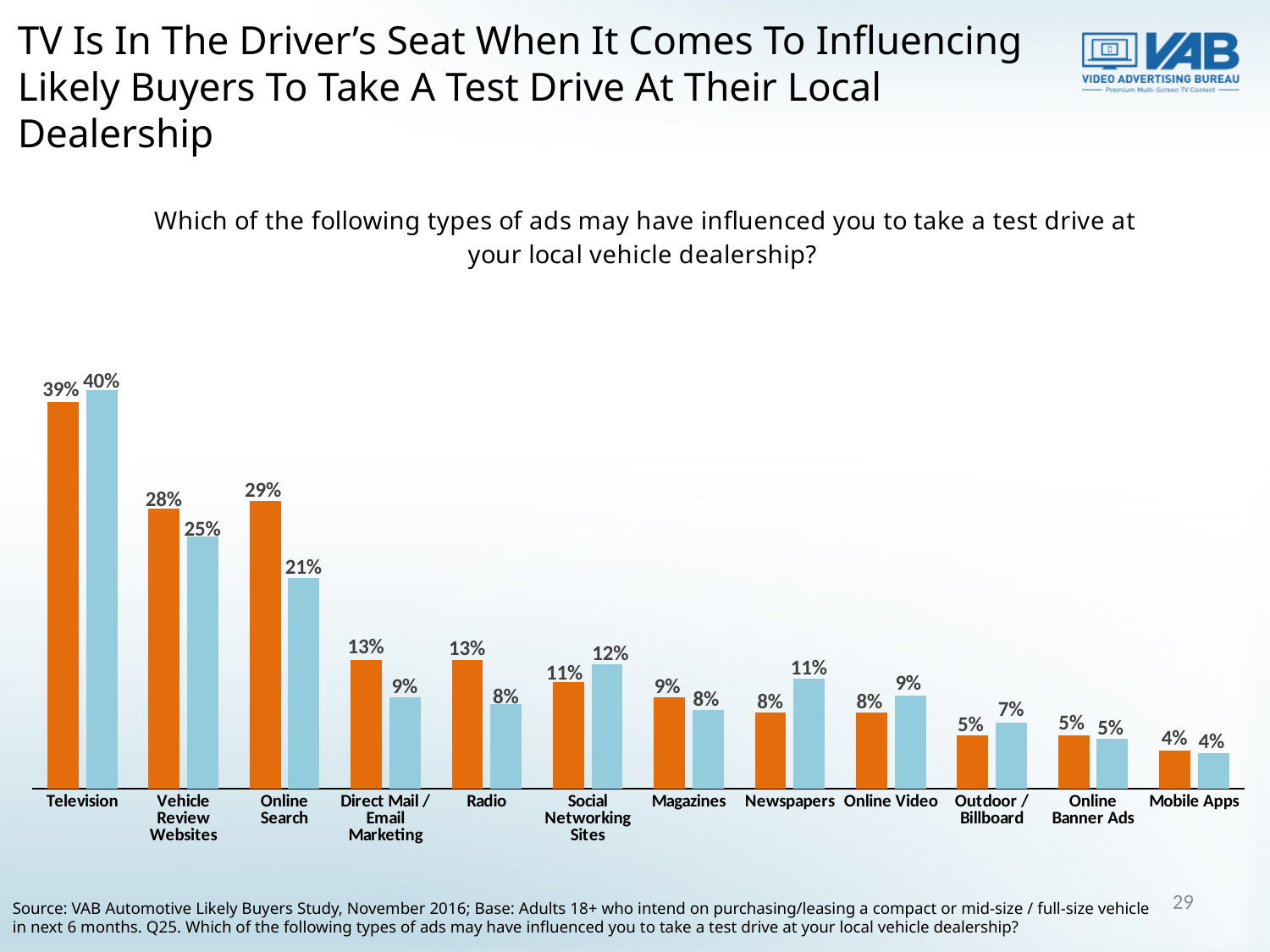
What is the value of the light blue bar for Online Search? 21% For Newspapers, which bar is larger, the orange or the light blue? light blue What is the difference between the orange bar for Vehicle Review Websites and the orange bar for Direct Mail / Email Marketing? 15% What is the difference between the orange and light blue bars for Online Search? 8% What is the value of the orange bar for Radio? 13% What kind of chart is shown on the slide? bar chart Which category has the lowest value for the orange bars? Mobile Apps What is the value of the light blue bar for Newspapers? 11% Which category has the highest value for the light blue bars? Television Do the orange bar values generally rise or fall from left to right across the categories? fall How many ad type categories are shown on the x axis? 12 What is the value of the orange bar for Television? 39%